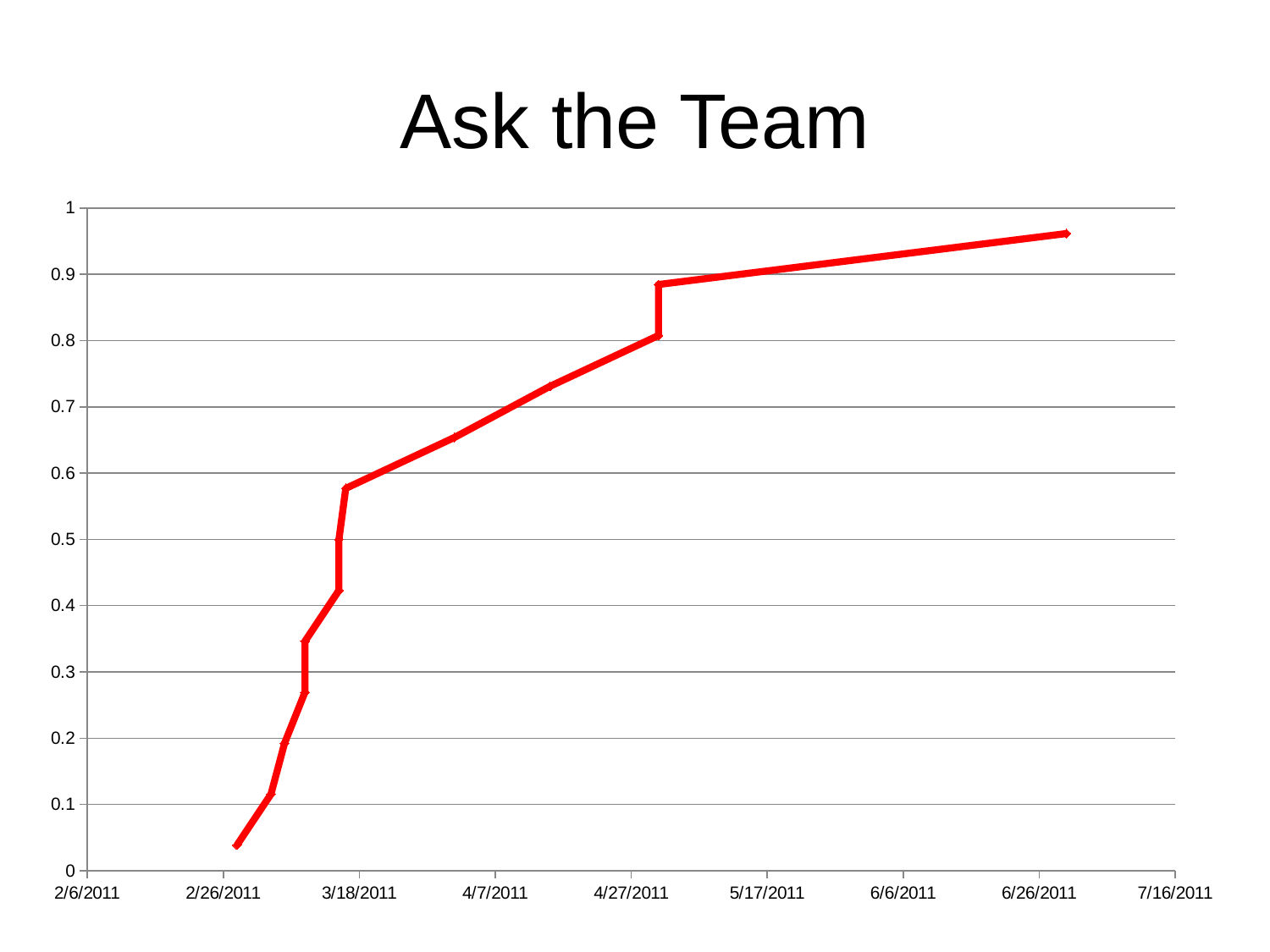
Do the values rise or fall as the dates move from left to right along the x axis? rise What colour is the plotted line? red What is the title of the chart? Ask the Team Which is larger, the value at the rightmost point or the value at the leftmost point? the rightmost point Is the lowest value on the line greater or less than 0.1? less How many lines (series) are plotted on the chart? 1 Is the value of the first (leftmost) point greater or less than 0.1? less What kind of chart is shown on the slide? line chart Is the value of the point plotted near 4/7/2011 greater or less than 0.6? greater